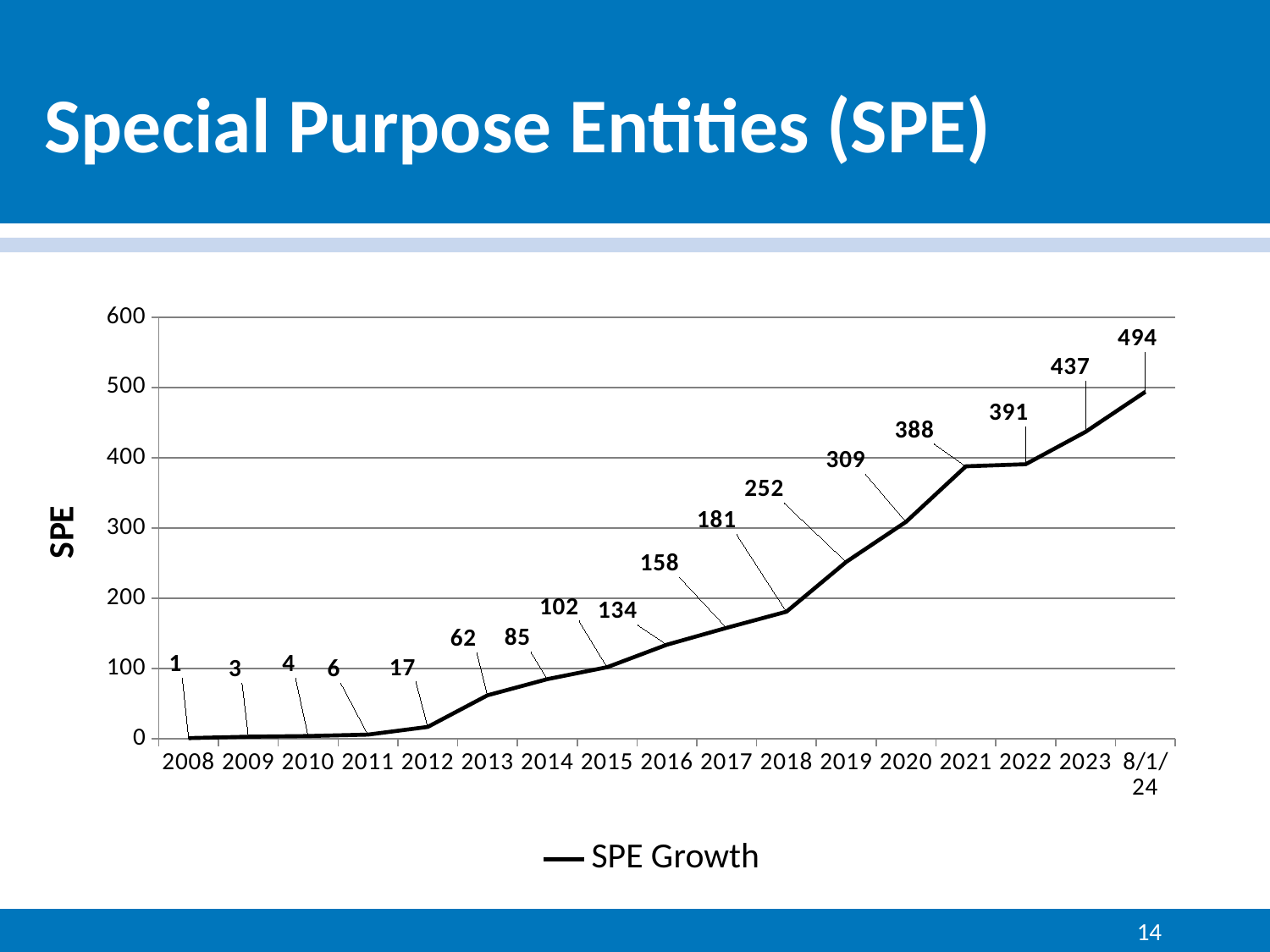
What is the SPE value for 2015? 102 Which is larger, the SPE value for 2018 or for 2019? 2019 How many data points are plotted on the chart? 17 Which point on the x axis has the highest SPE value? 8/1/24 Do the SPE values rise or fall from 2008 to 8/1/24? rise Which year has the lowest SPE value? 2008 Is the SPE value for 2021 greater or less than 300? greater How many series does the legend list? 1 What kind of chart is shown on the slide? line chart What is the difference between the SPE values for 2023 and 2022? 46 What is the SPE value for 2020? 309 What is the SPE value for 8/1/24? 494